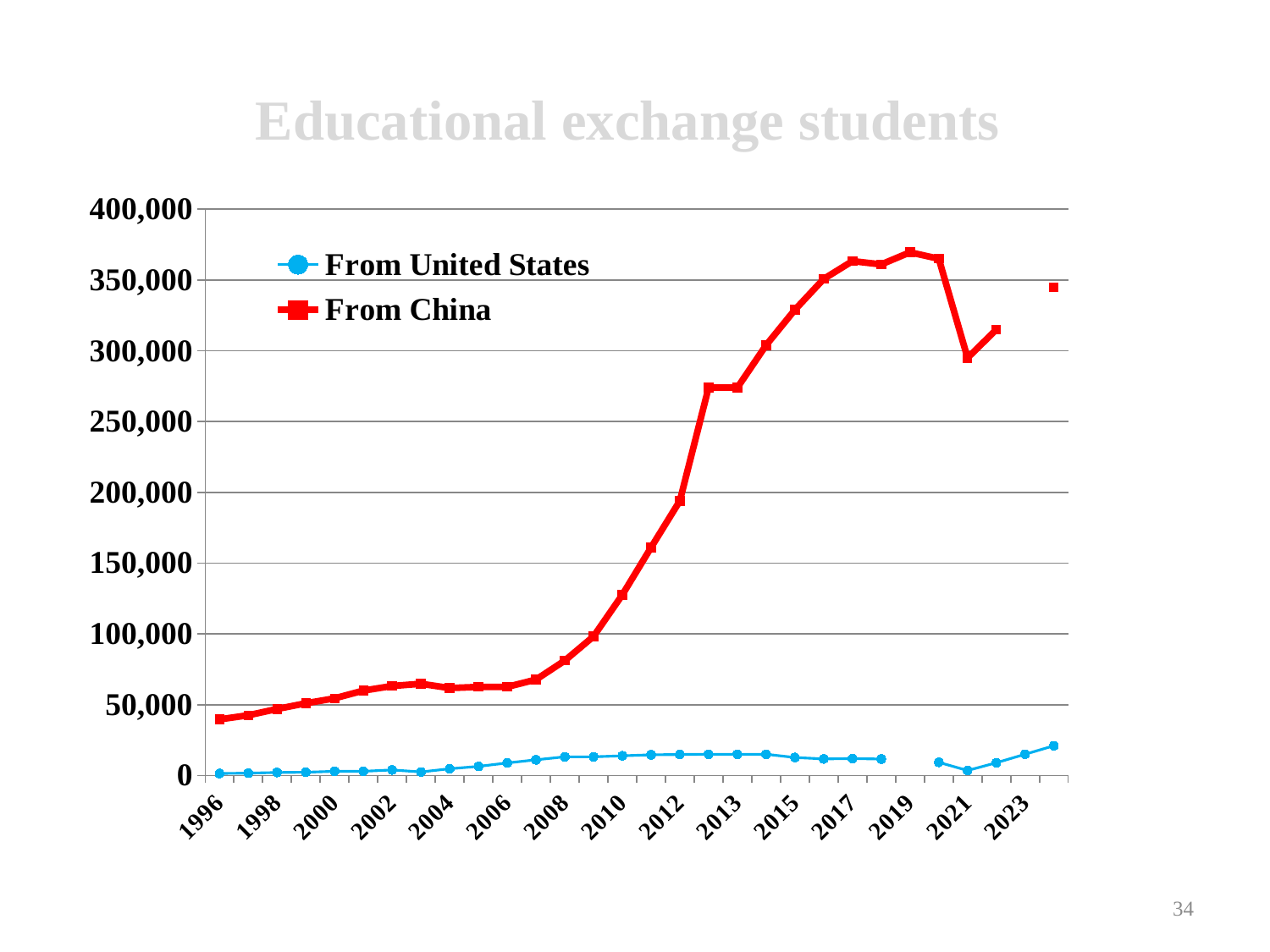
What is the title of the chart? Educational exchange students Which series has the larger value in 2017, From United States or From China? From China Is the value for From China in 1996 greater or less than 50,000? less What kind of chart is shown on the slide? Line chart Is the value for From China in 2017 greater or less than 350,000? greater In which year is the From China series at its lowest? 1996 In which year does the From China series reach its highest point? 2019 Which colour is used for the From China series? Red Does the From China series rise or fall between 2008 and 2013? Rise How many series does the legend list? 2 Is the value for From China in 2010 greater or less than 100,000? greater